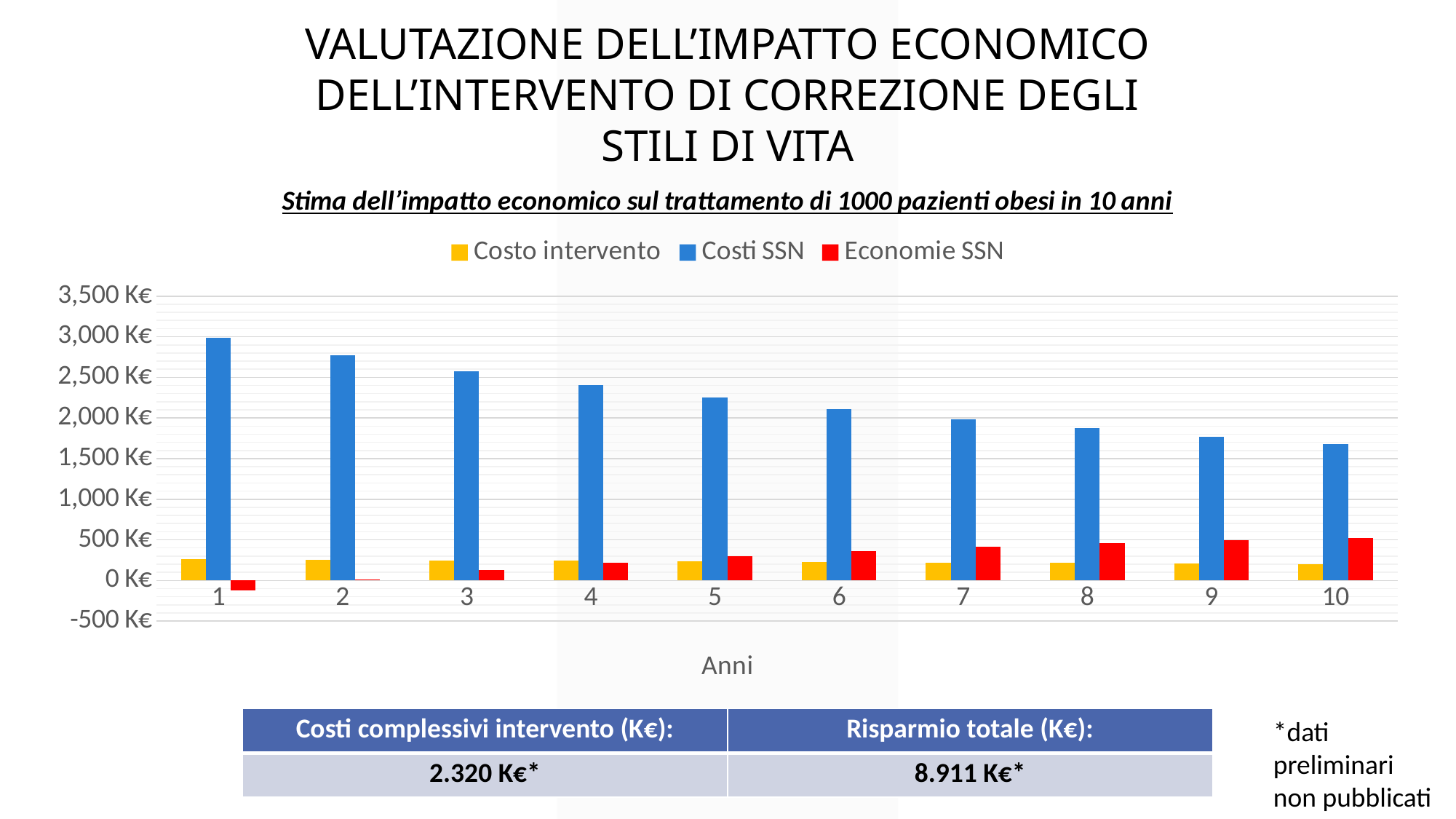
How many years (categories) are shown on the x axis? 10 Is the Economie SSN value for year 1 greater or less than 0 K€? less How many series does the legend list? 3 Which is larger, the Costi SSN value for year 3 or for year 8? year 3 Do the Costi SSN values rise or fall from year 1 to year 10? fall What kind of chart is shown on the slide? bar chart In which year is the Costi SSN value highest? 1 In which year is the Economie SSN value lowest? 1 Do the Economie SSN values rise or fall from year 1 to year 10? rise Is the Costi SSN value for year 1 greater or less than 2,500 K€? greater In which year is the Costi SSN value lowest? 10 Which colour represents the Economie SSN series in the legend? red